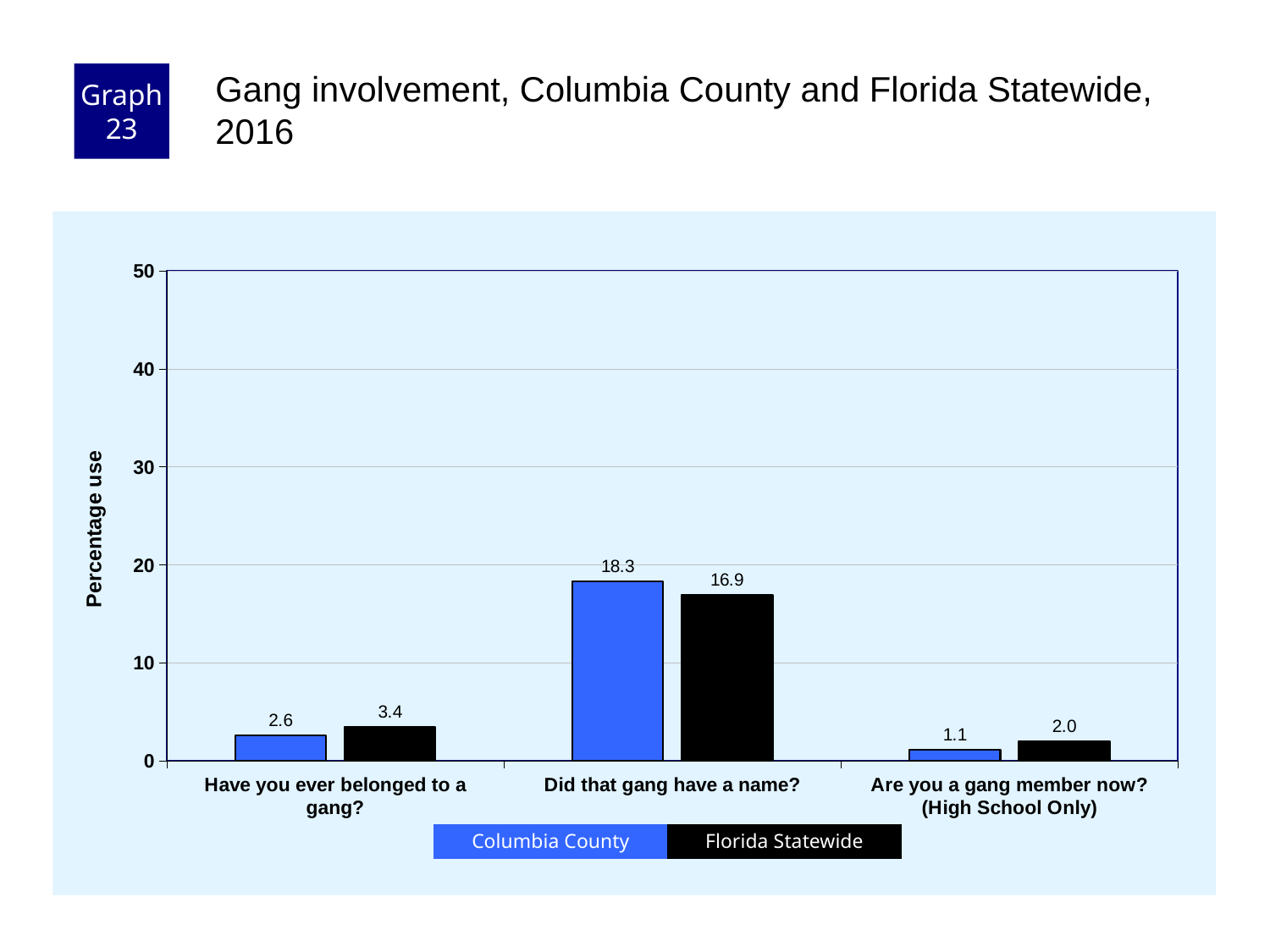
How many series does the legend list? 2 What is the difference between the Columbia County and Florida Statewide values for "Did that gang have a name?"? 1.4 Is the Columbia County value for "Did that gang have a name?" greater or less than 20? less What is the Columbia County value for "Did that gang have a name?"? 18.3 What is the label of the y axis? Percentage use Which question has the highest Florida Statewide value? Did that gang have a name? Which question has the lowest Columbia County value? Are you a gang member now? (High School Only) What kind of chart is shown on the slide? bar chart How many question categories are shown on the x axis? 3 What is the Columbia County value for "Are you a gang member now? (High School Only)"? 1.1 For "Are you a gang member now? (High School Only)", which is larger: Columbia County or Florida Statewide? Florida Statewide What is the Florida Statewide value for "Have you ever belonged to a gang?"? 3.4